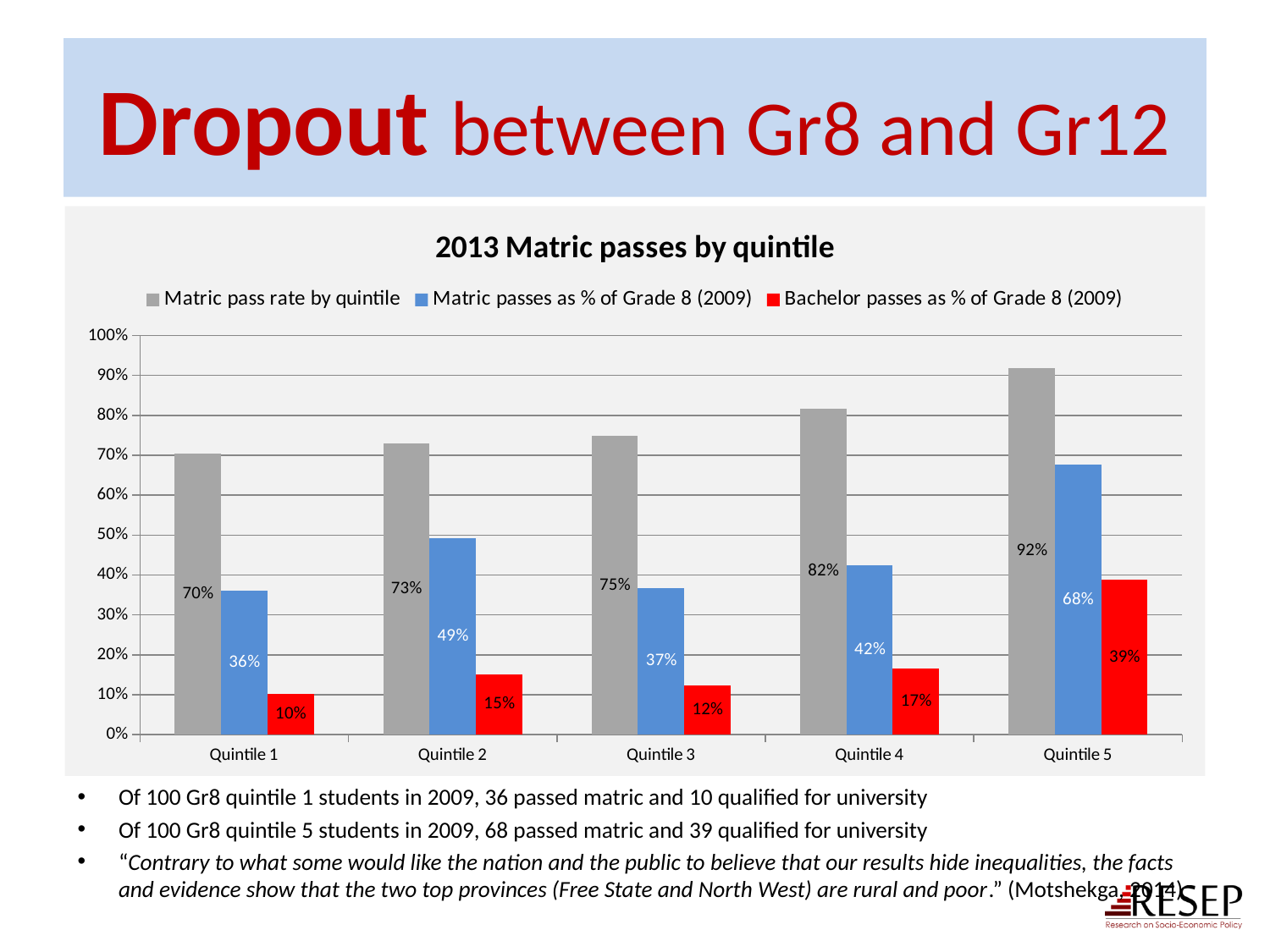
How many series does the legend list? 3 What is the Matric pass rate by quintile for Quintile 3? 75% Which quintile has the highest Matric pass rate by quintile? Quintile 5 What kind of chart is shown? Bar chart Does the Matric pass rate by quintile rise or fall from Quintile 1 to Quintile 5? Rise Which is larger: Matric passes as % of Grade 8 (2009) for Quintile 2 or for Quintile 3? Quintile 2 What is the difference between the Matric pass rate by quintile for Quintile 5 and Quintile 1? 22% How many quintiles are shown on the x axis? 5 Which quintile has the lowest Bachelor passes as % of Grade 8 (2009)? Quintile 1 What are Bachelor passes as % of Grade 8 (2009) for Quintile 4? 17% What is the title of the chart? 2013 Matric passes by quintile What are Matric passes as % of Grade 8 (2009) for Quintile 2? 49%